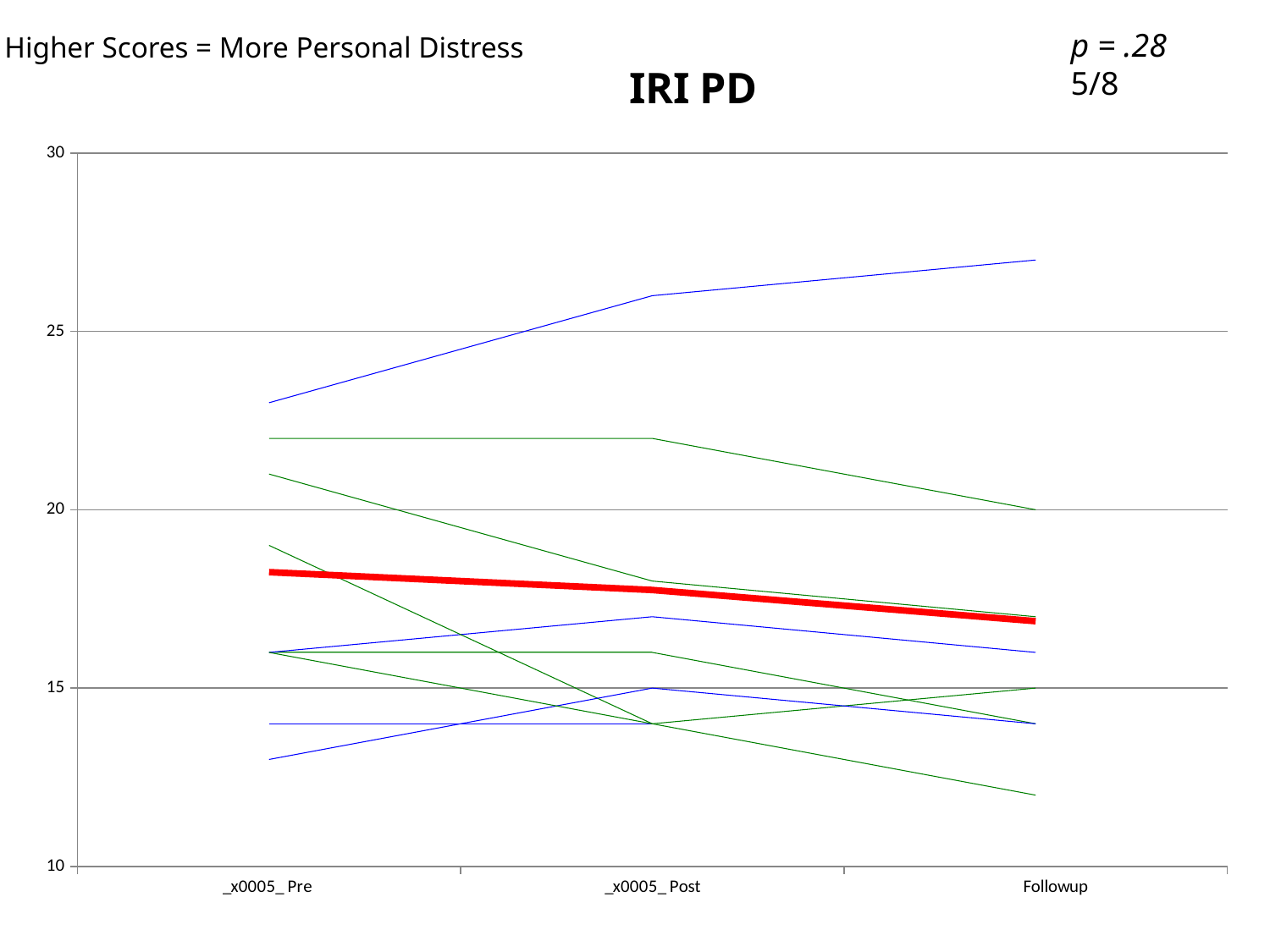
What is the maximum value shown on the y axis? 30 What kind of chart is shown on the slide? line chart Does the thick red line rise or fall from Pre to Followup? fall Does the topmost blue line rise or fall from Pre to Followup? rise How many categories are shown on the x axis? 3 Is the value of the lowest green line at Followup greater or less than 15? less Is the value of the topmost blue line at Pre greater or less than 25? less Is the value of the topmost blue line at Followup greater or less than 25? greater What is the label of the last category on the x axis? Followup What is the title of the chart? IRI PD